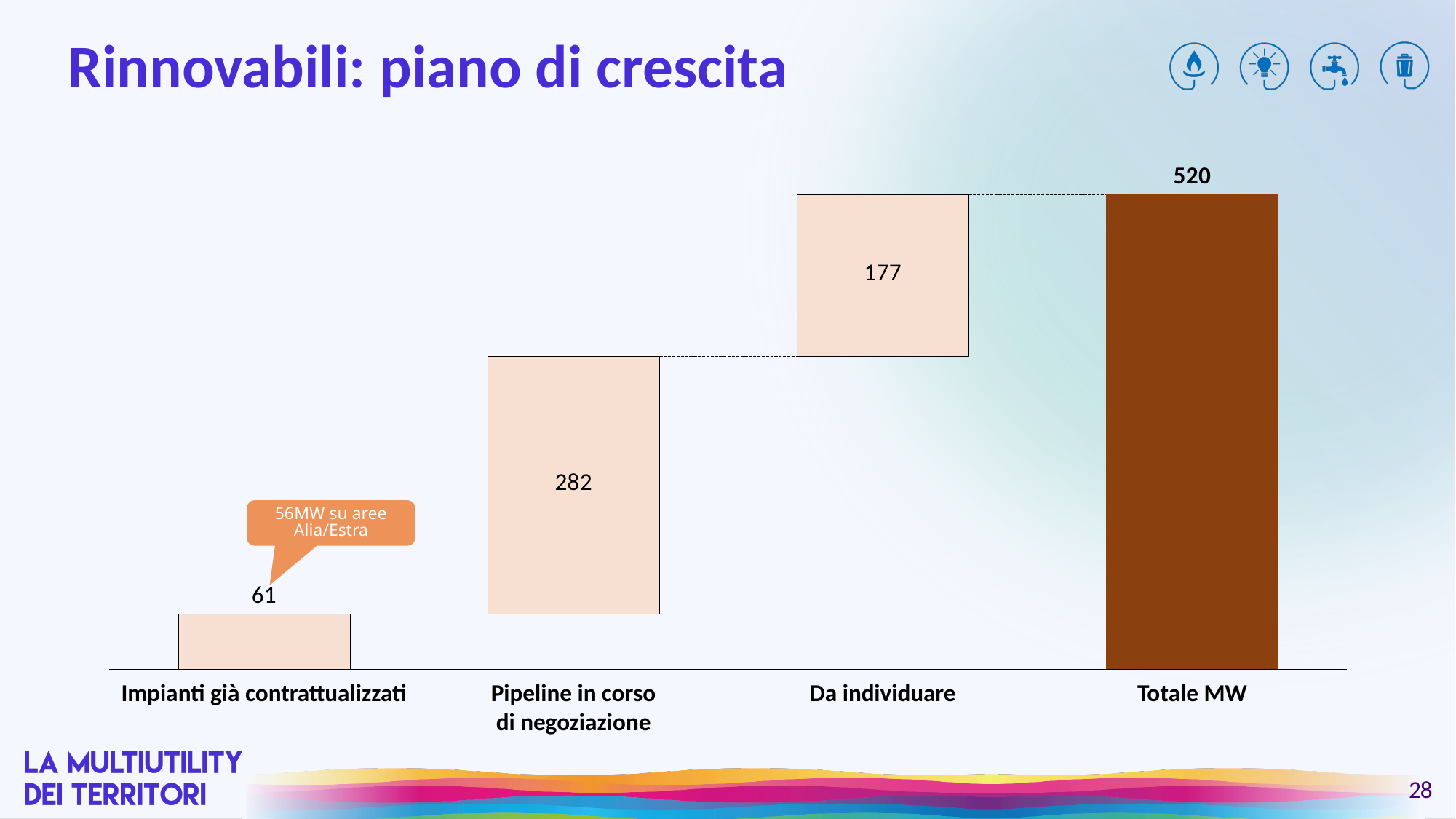
What is the value for "Pipeline in corso di negoziazione"? 282 How many categories are shown on the x axis of the chart? 4 What does the orange callout attached to the "Impianti già contrattualizzati" bar say? 56MW su aree Alia/Estra What is the value for "Impianti già contrattualizzati"? 61 What is the difference between the values for "Pipeline in corso di negoziazione" and "Da individuare"? 105 Which of the three contributing categories (excluding the total) has the highest value? Pipeline in corso di negoziazione What kind of chart is shown on the slide? Bar chart (waterfall) What is the value shown for "Totale MW"? 520 What is the value for "Da individuare"? 177 Which category has the lowest value? Impianti già contrattualizzati Which is larger, the value for "Da individuare" or the value for "Impianti già contrattualizzati"? Da individuare What is the difference between the values for "Da individuare" and "Impianti già contrattualizzati"? 116